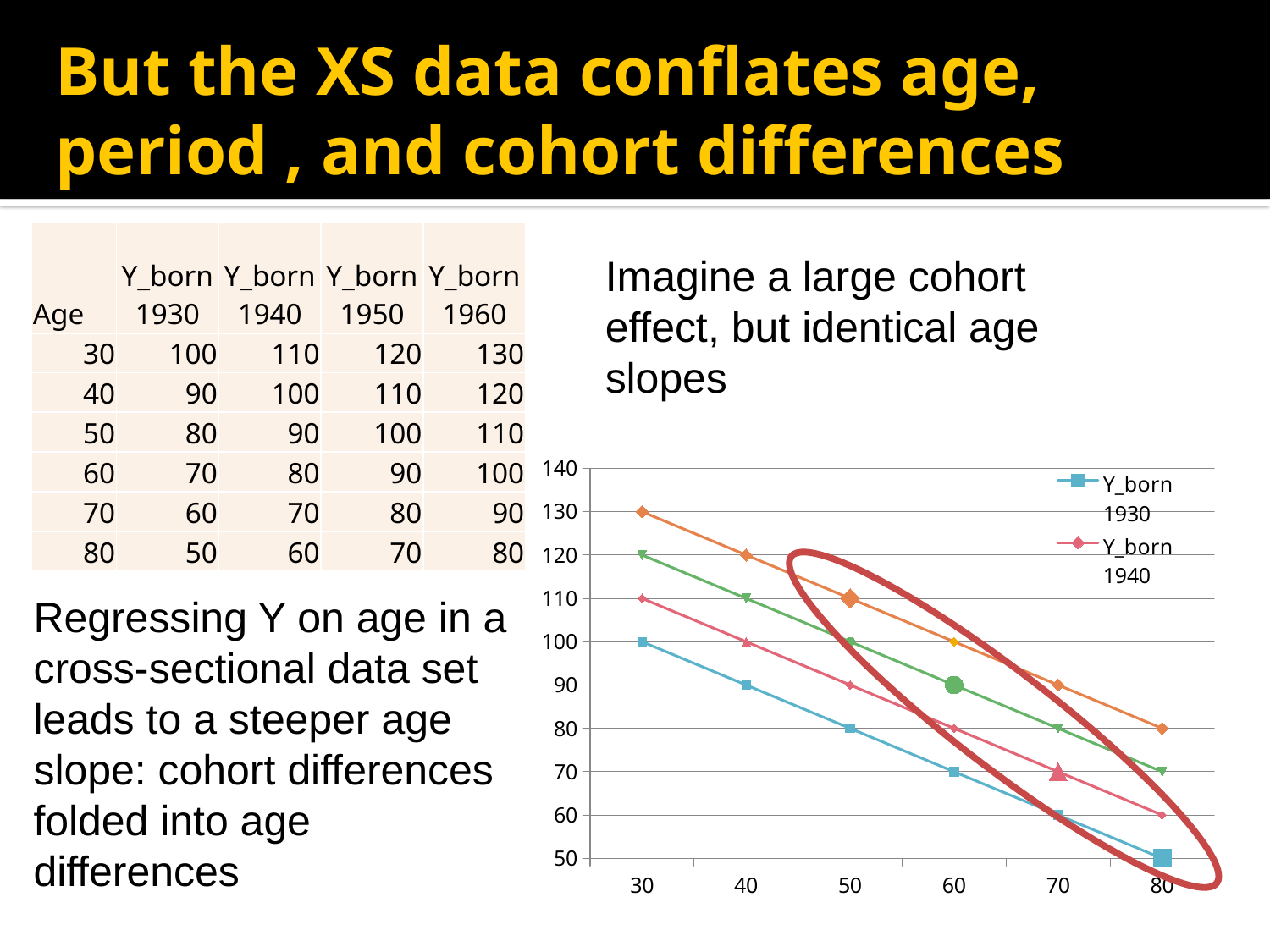
What is the value of the Y_born 1930 line at age 80? 50 How many age values are shown along the x axis of the chart? 6 Do the values of the Y_born 1930 line rise or fall as age increases? fall How many lines are plotted on the chart? 4 At which age does the Y_born 1940 line reach its lowest value? 80 At age 50, which line has the higher value, Y_born 1930 or Y_born 1940? Y_born 1940 At which age does the Y_born 1930 line reach its highest value? 30 What is the value of the Y_born 1940 line at age 80? 60 What kind of chart is shown on the slide? line chart What is the difference between the Y_born 1940 and Y_born 1930 values at age 30? 10 What is the value of the Y_born 1930 line at age 30? 100 Is the value of the Y_born 1930 line at age 60 greater or less than 100? less